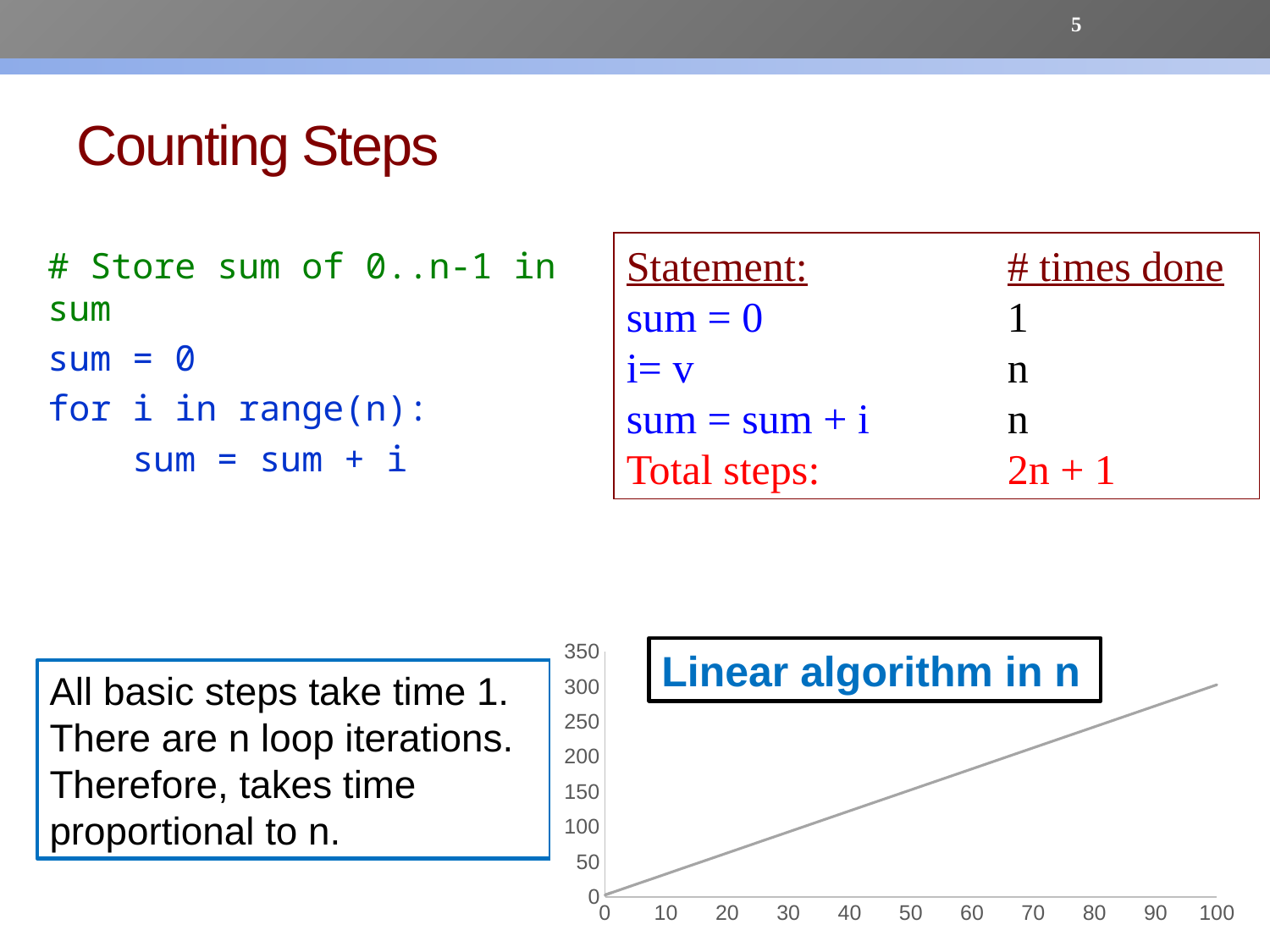
Is the value of the line at x = 50 greater or less than 200? less Is the value of the line at x = 50 greater or less than 100? greater Is the value of the line at x = 80 greater or less than 200? greater What is the highest value labelled on the chart's y-axis? 350 What is the title shown on the chart? Linear algorithm in n What kind of chart is shown at the bottom right of the slide? line chart Does the plotted line rise or fall as the x-axis value increases from 0 to 100? rise